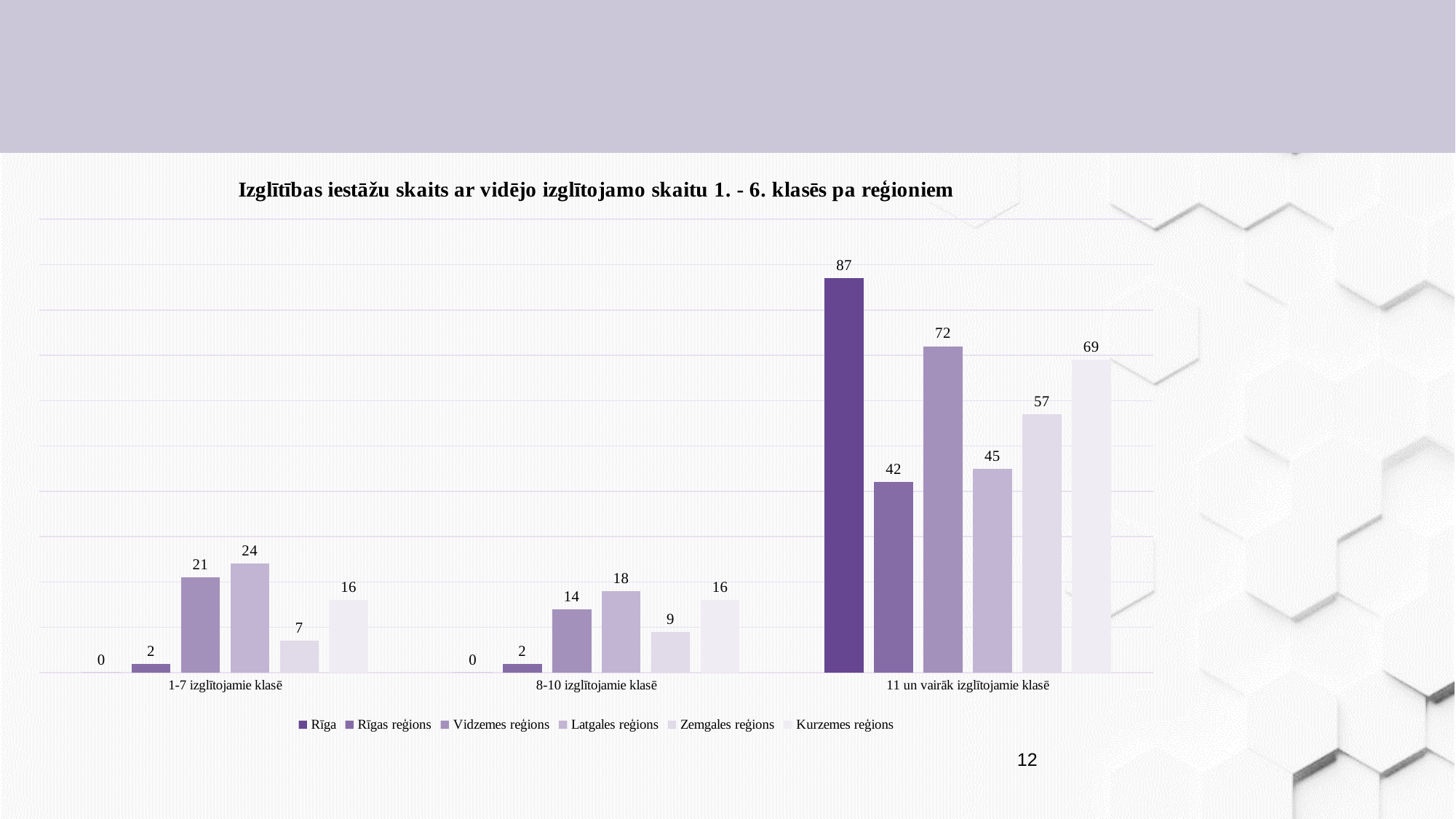
What is the difference between Vidzemes reģions and Rīgas reģions in the '11 un vairāk izglītojamie klasē' category? 30 What is the value for Latgales reģions in the '1-7 izglītojamie klasē' category? 24 Which region has the highest value in the '11 un vairāk izglītojamie klasē' category? Rīga How many series does the legend list? 6 Which region has the lowest value in the '1-7 izglītojamie klasē' category? Rīga What is the value for Rīga in the '11 un vairāk izglītojamie klasē' category? 87 What is the difference between Kurzemes reģions and Zemgales reģions in the '1-7 izglītojamie klasē' category? 9 What is the title of the chart? Izglītības iestāžu skaits ar vidējo izglītojamo skaitu 1. - 6. klasēs pa reģioniem What is the value for Zemgales reģions in the '8-10 izglītojamie klasē' category? 9 What kind of chart is shown on the slide? Bar chart Which is larger in the '8-10 izglītojamie klasē' category: Latgales reģions or Kurzemes reģions? Latgales reģions How many categories are shown on the x axis? 3